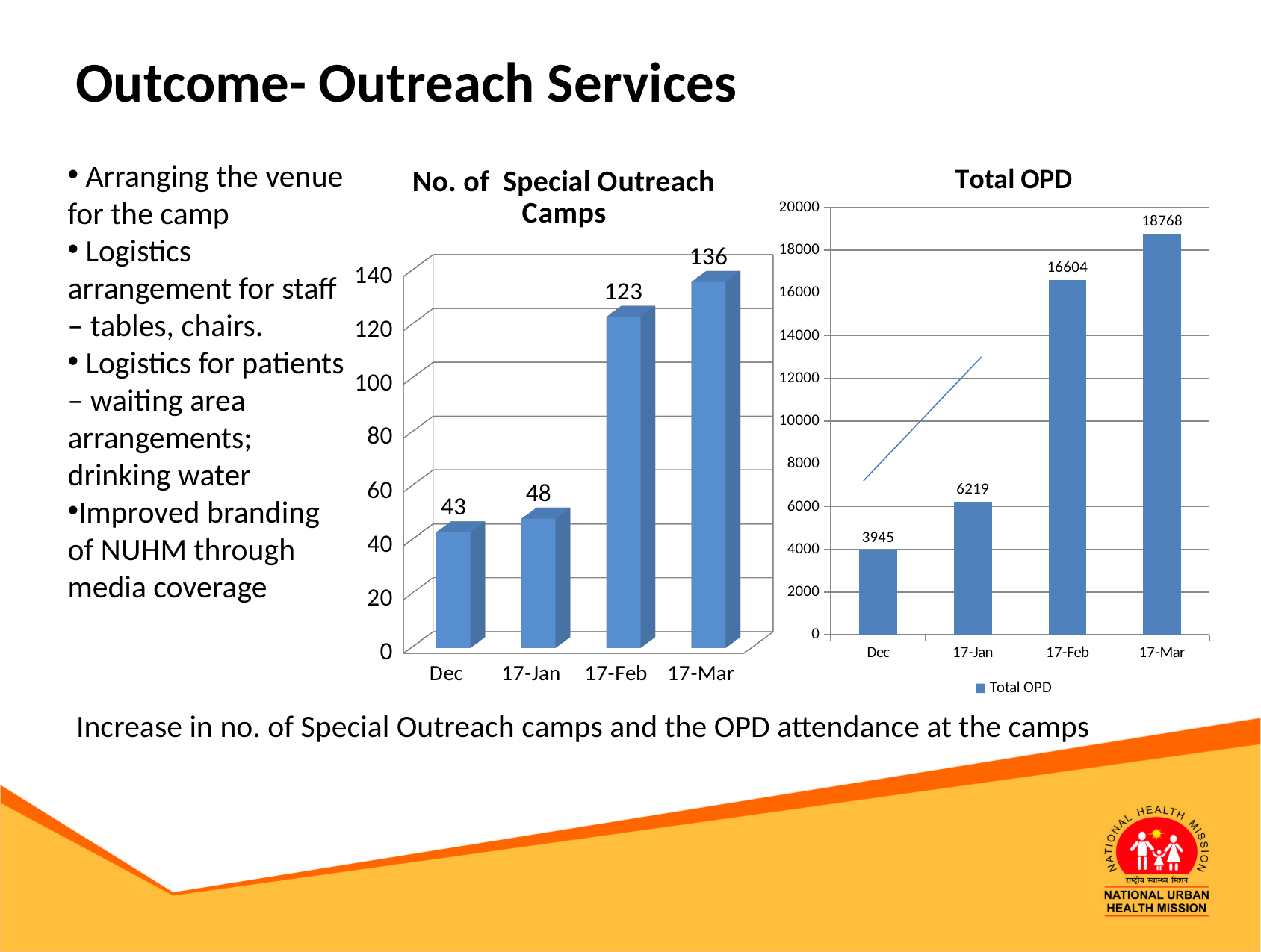
In the 'Total OPD' chart, what is the value for 17-Mar? 18768 In the 'No. of Special Outreach Camps' chart, how many categories are shown on the x axis? 4 In the 'No. of Special Outreach Camps' chart, do the values rise or fall from Dec to 17-Mar? rise In the 'No. of Special Outreach Camps' chart, what is the difference between the values for 17-Mar and 17-Feb? 13 In the 'Total OPD' chart, what is the value for 17-Jan? 6219 In the 'Total OPD' chart, is the value for 17-Feb greater or less than 16000? greater In the 'No. of Special Outreach Camps' chart, which category has the lowest value? Dec What kind of chart is the 'Total OPD' chart? bar chart In the 'Total OPD' chart, which category has the lowest value? Dec In the 'Total OPD' chart, what is the difference between the values for 17-Feb and 17-Jan? 10385 In the 'No. of Special Outreach Camps' chart, what is the value for 17-Feb? 123 In the 'No. of Special Outreach Camps' chart, which category has the highest value? 17-Mar